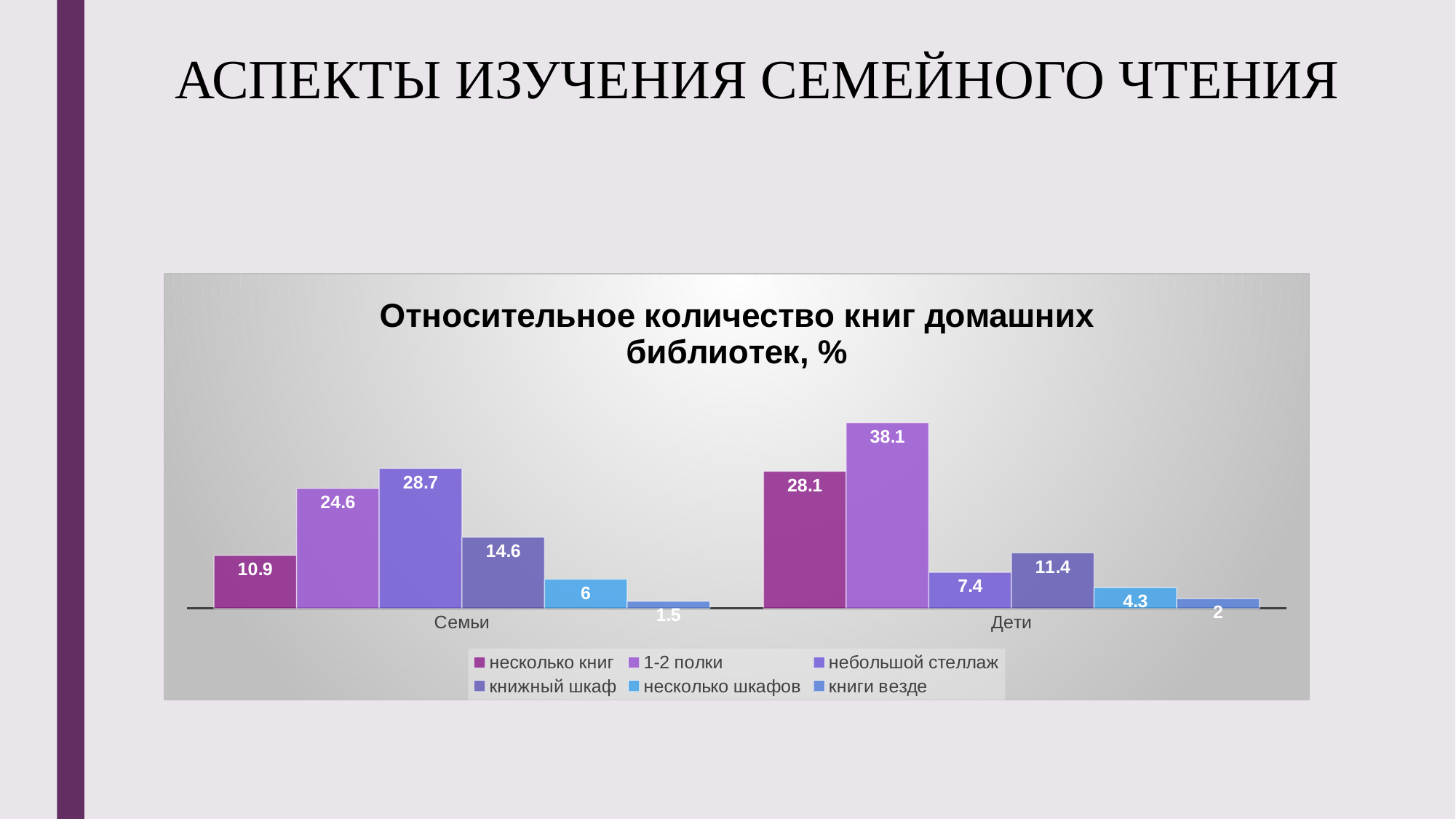
What is the value for 'небольшой стеллаж' in the 'Семьи' category? 28.7 How many series does the legend list? 6 Which is larger: 'книжный шкаф' for 'Семьи' or 'книжный шкаф' for 'Дети'? Семьи What is the value for '1-2 полки' in the 'Дети' category? 38.1 Which series has the lowest value in the 'Семьи' category? книги везде Which series has the highest value in the 'Дети' category? 1-2 полки How many categories are shown on the x axis? 2 What is the value for 'книги везде' in the 'Семьи' category? 1.5 What is the value for 'несколько шкафов' in the 'Дети' category? 4.3 What type of chart is shown on the slide? bar chart What is the title of the chart? Относительное количество книг домашних библиотек, % What is the difference between the 'несколько книг' values for 'Дети' and 'Семьи'? 17.2